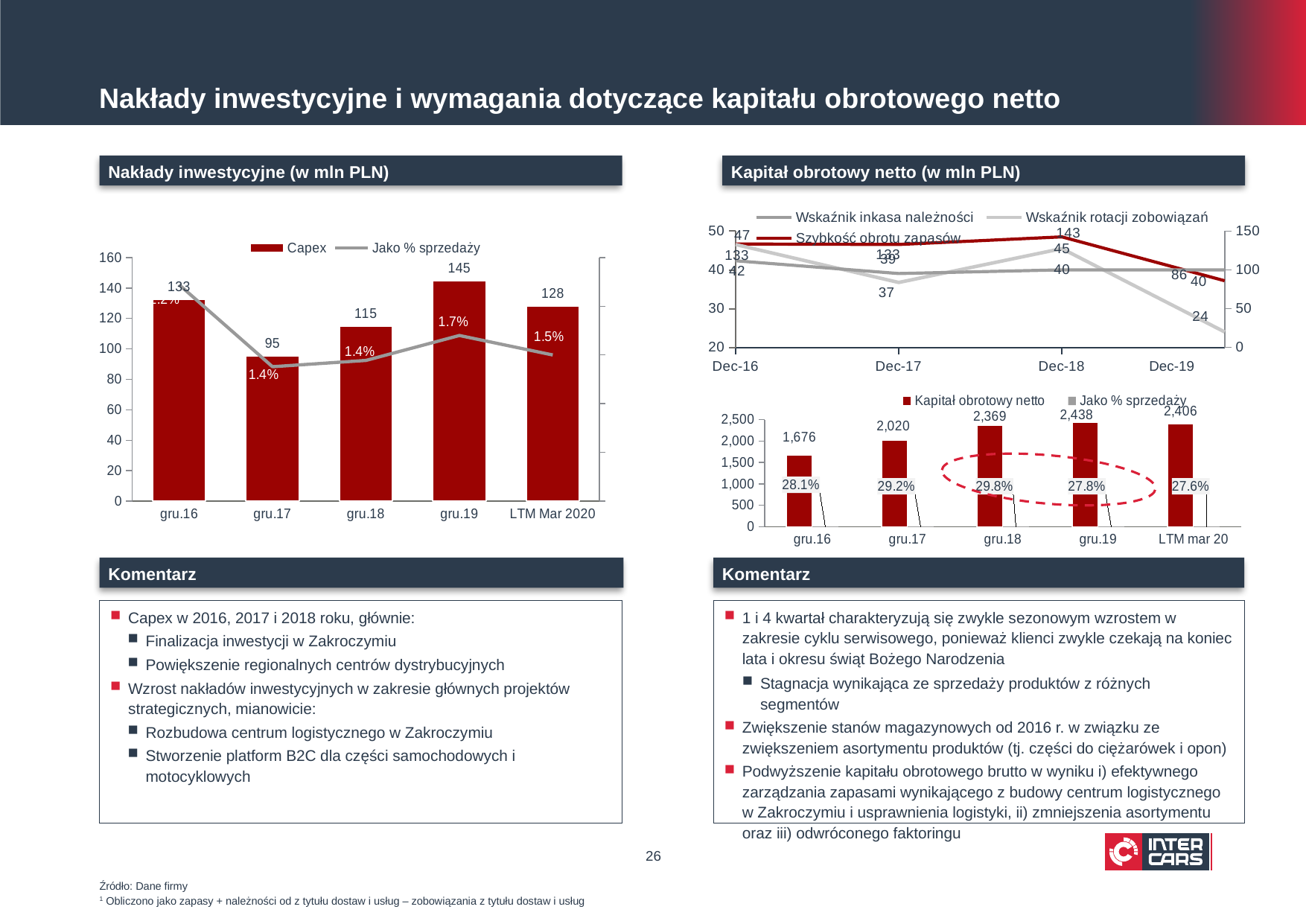
In the 'Nakłady inwestycyjne (w mln PLN)' chart, what is the difference between Capex in gru.19 and gru.18? 30 In the 'Kapitał obrotowy netto (w mln PLN)' bar chart, what is the Kapitał obrotowy netto value for gru.18? 2,369 In the 'Nakłady inwestycyjne (w mln PLN)' chart, what is the 'Jako % sprzedaży' value for LTM Mar 2020? 1.5% In the 'Kapitał obrotowy netto (w mln PLN)' bar chart, is Kapitał obrotowy netto larger in gru.16 or gru.17? gru.17 In the 'Nakłady inwestycyjne (w mln PLN)' chart, what is the Capex value for gru.19? 145 In the 'Nakłady inwestycyjne (w mln PLN)' chart, which period has the lowest Capex? gru.17 In the 'Nakłady inwestycyjne (w mln PLN)' chart, how many periods are shown on the x axis? 5 How many series does the legend of the line chart under 'Kapitał obrotowy netto (w mln PLN)' list? 3 In the 'Nakłady inwestycyjne (w mln PLN)' chart, what is the Capex value for gru.17? 95 In the 'Kapitał obrotowy netto (w mln PLN)' bar chart, what is the 'Jako % sprzedaży' value for gru.17? 29.2% In the 'Kapitał obrotowy netto (w mln PLN)' bar chart, what is the difference between Kapitał obrotowy netto in gru.17 and gru.16? 344 In the 'Kapitał obrotowy netto (w mln PLN)' bar chart, which period has the highest Kapitał obrotowy netto? gru.19